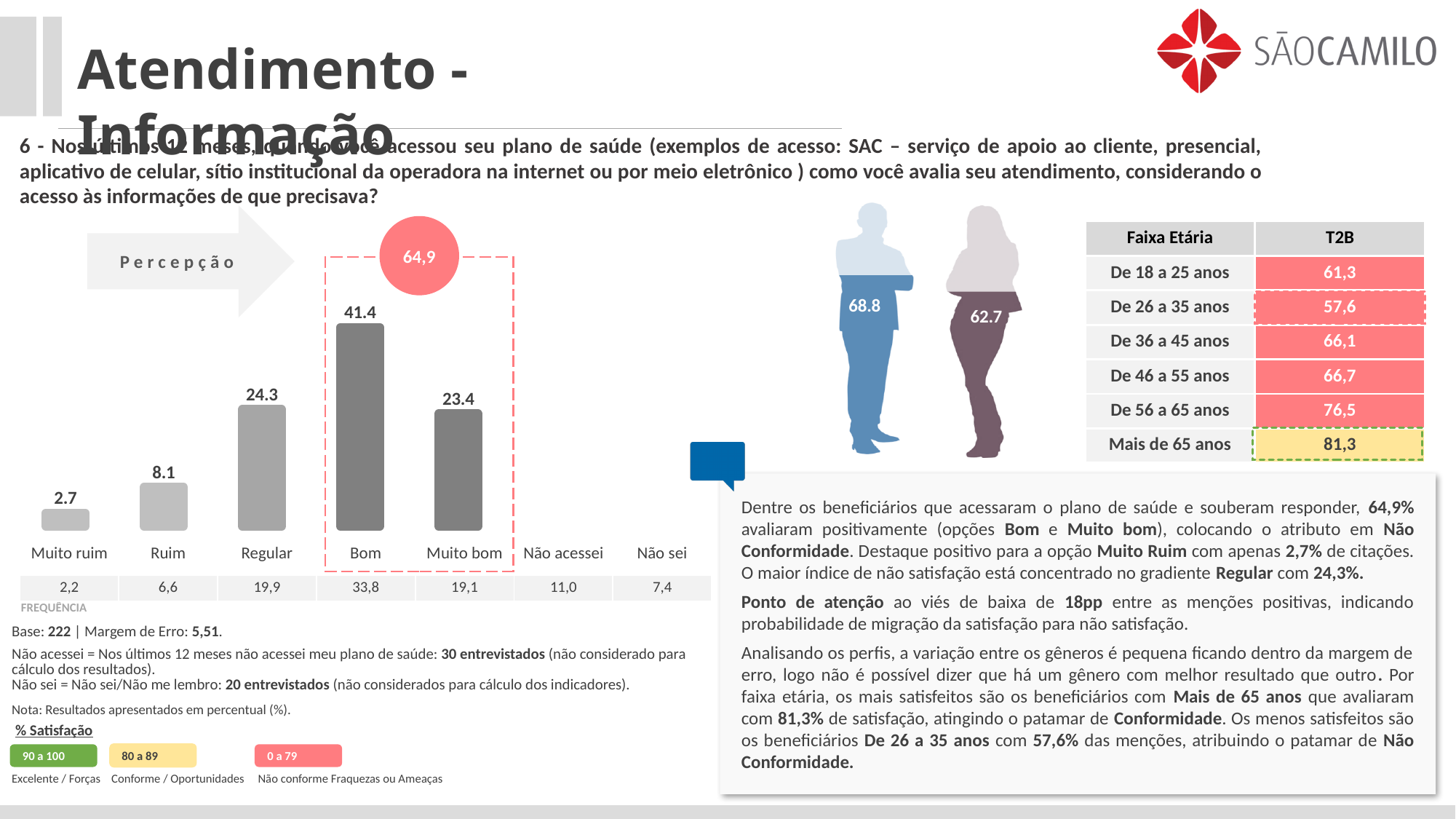
In the bar chart, what is the value for Bom? 41.4 In the bar chart, what is the value for Muito bom? 23.4 In the bar chart, what is the value for Muito ruim? 2.7 Which category has the highest bar in the bar chart? Bom In the bar chart, what is the value for Regular? 24.3 What kind of chart is shown on the left of the slide? bar chart Which category has the lowest bar in the bar chart? Muito ruim How many categories in the bar chart have a bar plotted? 5 What value is shown in the red circle above the Bom and Muito bom bars? 64,9 In the bar chart, what is the difference between the values for Bom and Muito bom? 18.0 In the bar chart, which is larger, the value for Regular or the value for Ruim? Regular In the bar chart, what is the value for Ruim? 8.1